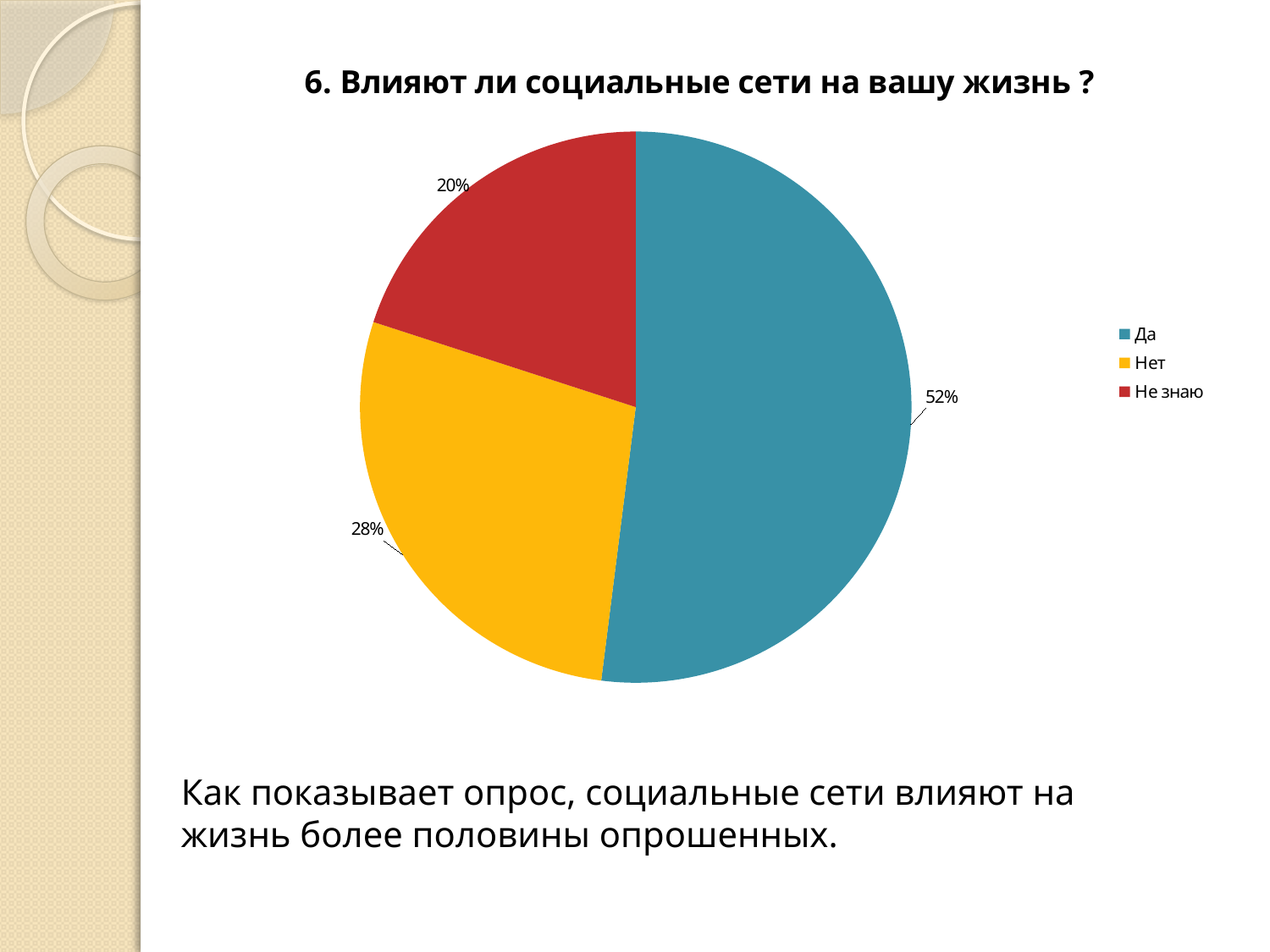
Which slice is larger, "Нет" or "Не знаю"? Нет What share of the pie does the "Не знаю" slice represent? 20% Which category has the smallest slice of the pie? Не знаю What is the title of the chart? 6. Влияют ли социальные сети на вашу жизнь ? What is the difference in percentage points between the "Да" and "Нет" slices? 24 Which category has the largest slice of the pie? Да What colour is the "Нет" slice in the pie chart? Yellow How many categories does the pie chart show? 3 What share of the pie does the "Да" slice represent? 52% What kind of chart is shown on the slide? Pie chart What share of the pie does the "Нет" slice represent? 28% What is the difference in percentage points between the "Нет" and "Не знаю" slices? 8